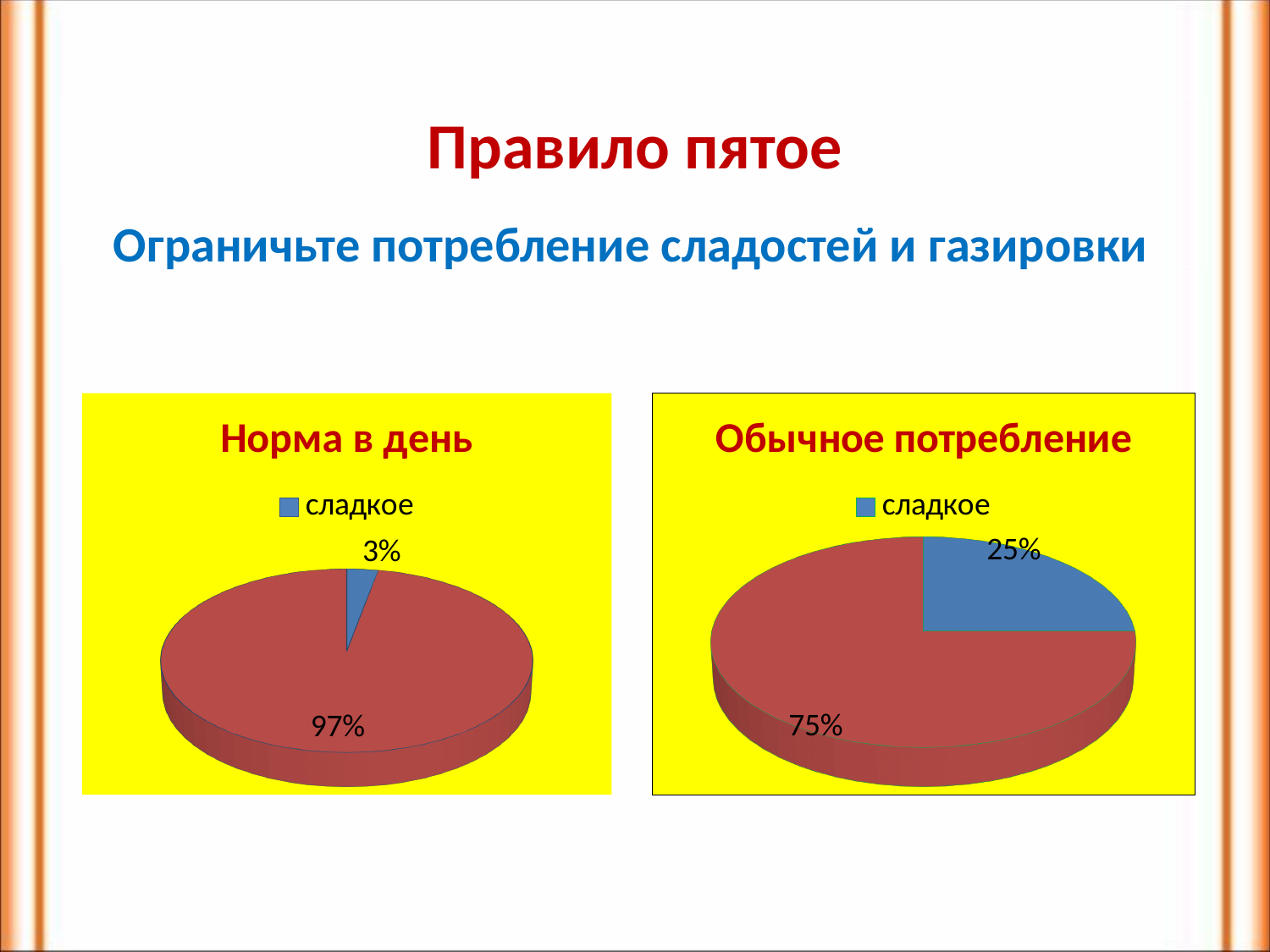
Which chart has the larger "сладкое" slice, "Норма в день" or "Обычное потребление"? Обычное потребление In the "Обычное потребление" chart, which slice is the smallest? сладкое (25%) In the "Обычное потребление" chart, what percentage is shown on the red slice? 75% How many entries does the legend of the "Норма в день" chart list? 1 How many slices does the "Обычное потребление" pie chart have? 2 In the "Норма в день" chart, what percentage is shown on the red slice? 97% What is the difference between the "сладкое" share in the "Обычное потребление" chart and in the "Норма в день" chart? 22% What type of chart is the "Норма в день" chart? pie chart In the "Обычное потребление" chart, what share does the "сладкое" slice have? 25% In the "Норма в день" chart, which slice is the largest? the red slice (97%) In the "Норма в день" chart, what share does the "сладкое" slice have? 3% What is the title of the chart on the right side of the slide? Обычное потребление